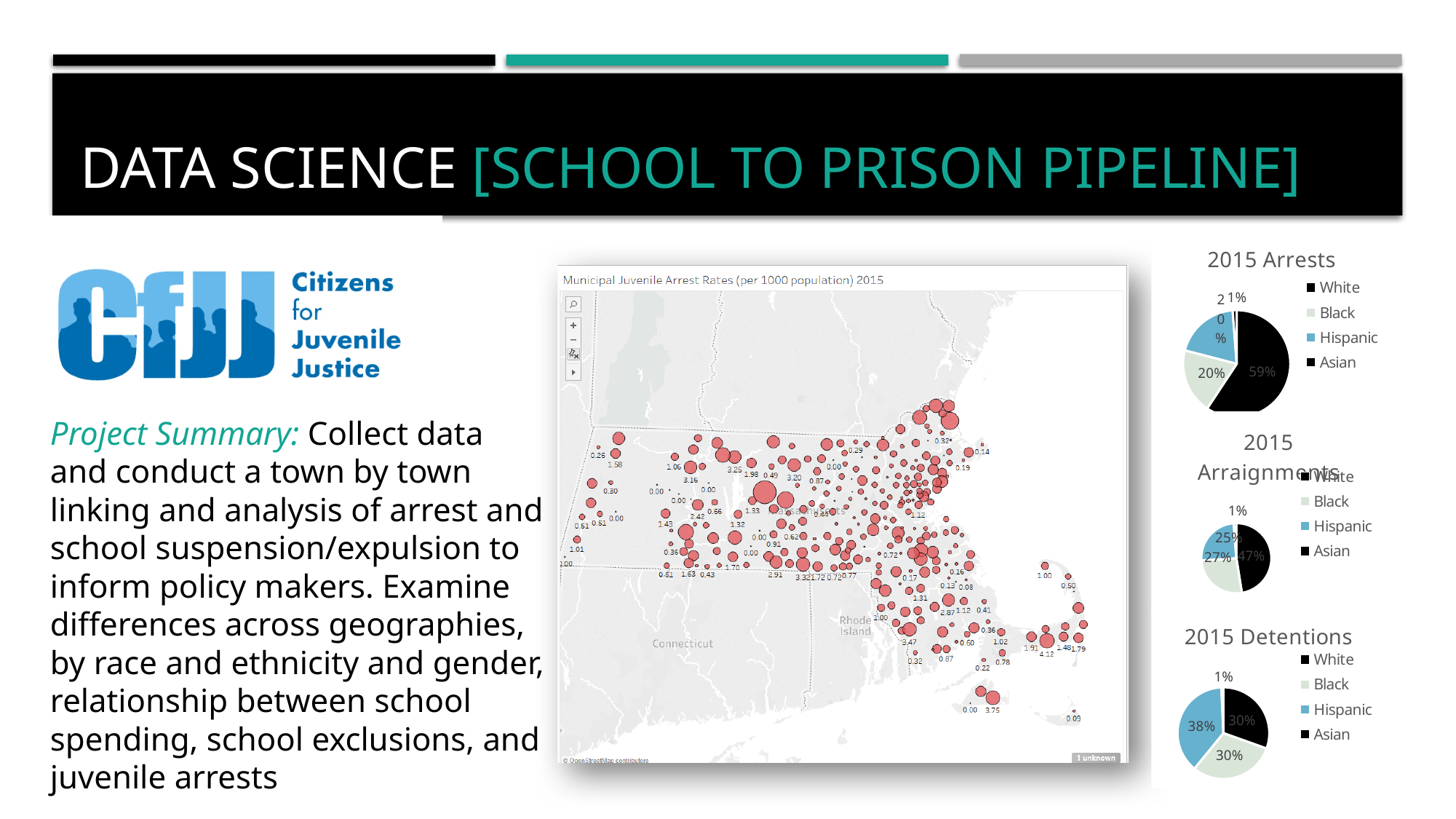
In the 2015 Detentions pie chart, which group has the smallest share? Asian In the 2015 Detentions pie chart, what share is Hispanic? 38% In the 2015 Arraignments pie chart, what share is White? 47% In the 2015 Arraignments pie chart, what share is Hispanic? 25% In the 2015 Arrests pie chart, what share of arrests is White? 59% How many groups does the legend of the 2015 Detentions pie chart list? 4 What kind of chart is used for 2015 Arrests, 2015 Arraignments and 2015 Detentions? Pie chart In the 2015 Arrests pie chart, which group has the largest share? White In the 2015 Arrests pie chart, what share is Asian? 1% In the 2015 Detentions pie chart, which group has the largest share? Hispanic In the 2015 Arraignments pie chart, what is the difference between the Black share and the Hispanic share? 2% What is the title of the map chart in the centre of the slide? Municipal Juvenile Arrest Rates (per 1000 population) 2015